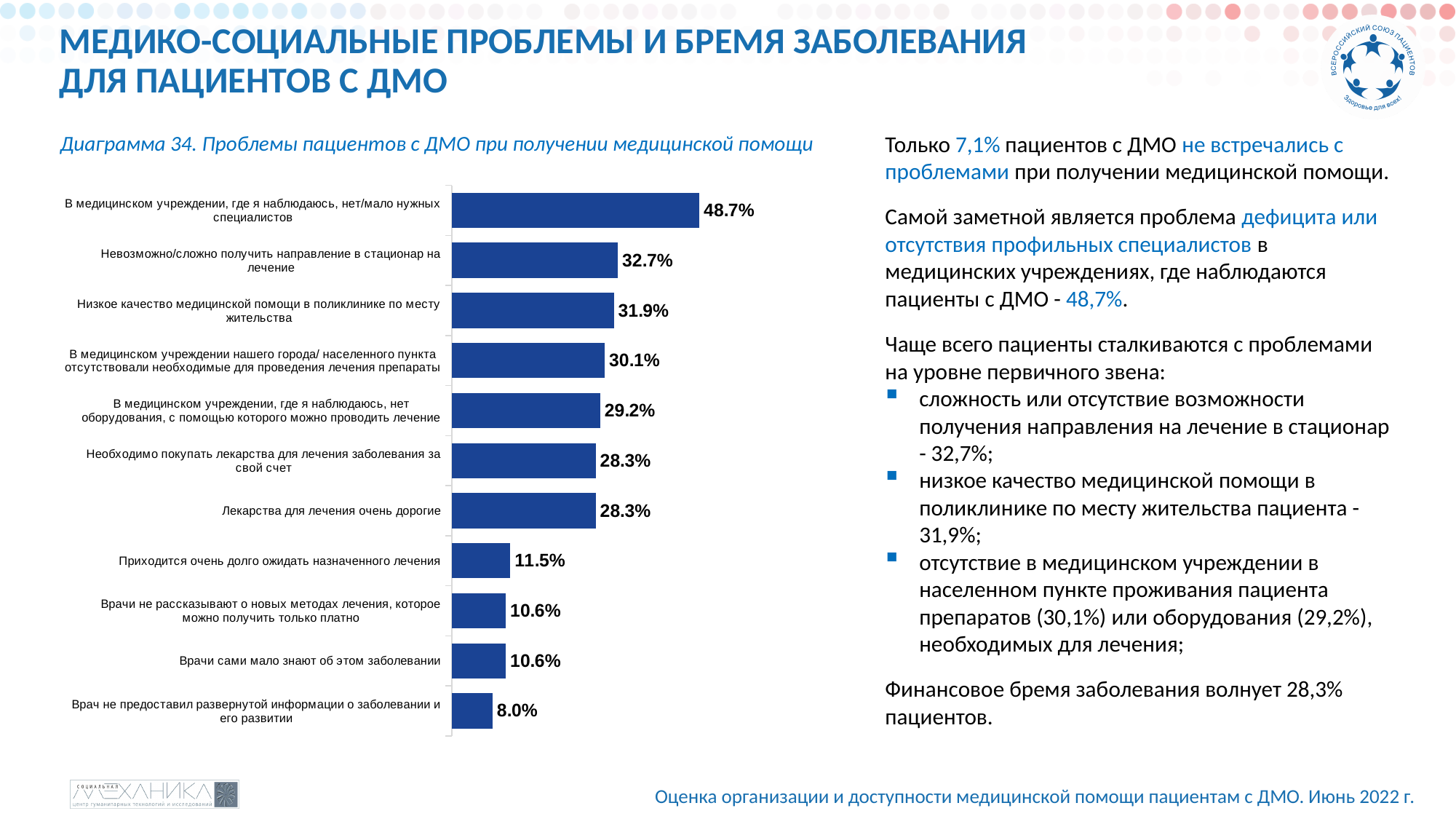
Which is larger: the value for "Низкое качество медицинской помощи в поликлинике по месту жительства" or the value for "Приходится очень долго ожидать назначенного лечения"? Низкое качество медицинской помощи в поликлинике по месту жительства What is the value for "Невозможно/сложно получить направление в стационар на лечение"? 32.7% What is the value for "Лекарства для лечения очень дорогие"? 28.3% What is the title of the chart? Диаграмма 34. Проблемы пациентов с ДМО при получении медицинской помощи Which category has the highest value? В медицинском учреждении, где я наблюдаюсь, нет/мало нужных специалистов Which category has the lowest value? Врач не предоставил развернутой информации о заболевании и его развитии What kind of chart is shown on the slide? Bar chart What is the value for "Врачи сами мало знают об этом заболевании"? 10.6% What is the value for "Приходится очень долго ожидать назначенного лечения"? 11.5% How many categories are shown in the chart? 11 What is the difference between the values for "Приходится очень долго ожидать назначенного лечения" and "Врач не предоставил развернутой информации о заболевании и его развитии"? 3.5% What is the difference between the values for "В медицинском учреждении, где я наблюдаюсь, нет/мало нужных специалистов" and "Невозможно/сложно получить направление в стационар на лечение"? 16.0%